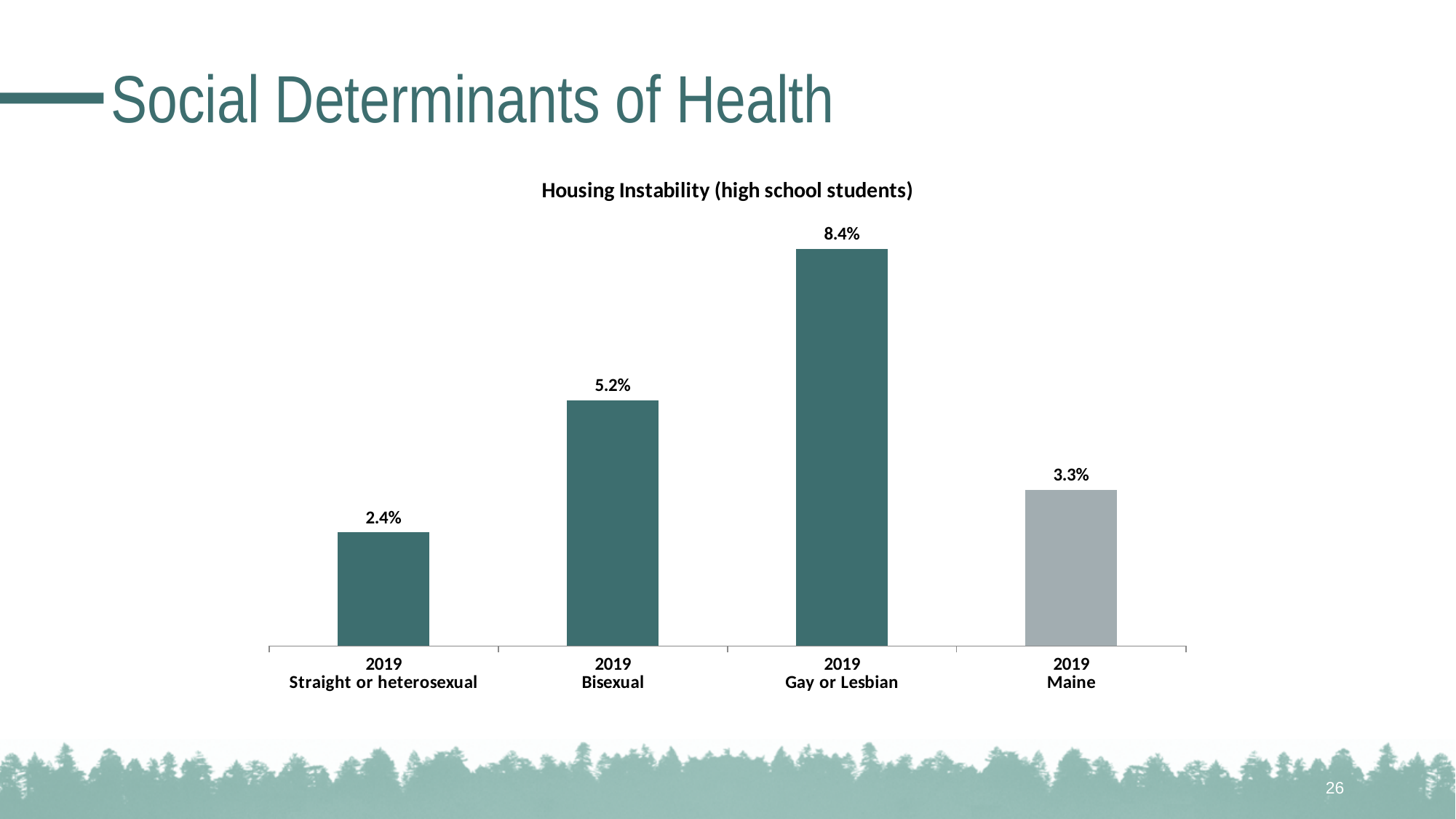
What is the difference between the housing instability values for Bisexual students and Maine overall? 1.9% What is the housing instability value for Gay or Lesbian high school students in 2019? 8.4% Which is larger, the housing instability value for Maine or for Straight or heterosexual students? Maine Which category has the highest housing instability value? Gay or Lesbian What kind of chart is shown on the slide? Bar chart What is the title of the chart? Housing Instability (high school students) What is the difference between the housing instability values for Gay or Lesbian and Straight or heterosexual students? 6.0% How many categories are shown in the chart? 4 Which category has the lowest housing instability value? Straight or heterosexual What is the housing instability value for Bisexual high school students in 2019? 5.2% What is the housing instability value for Straight or heterosexual high school students in 2019? 2.4% What is the housing instability value for Maine overall in 2019? 3.3%